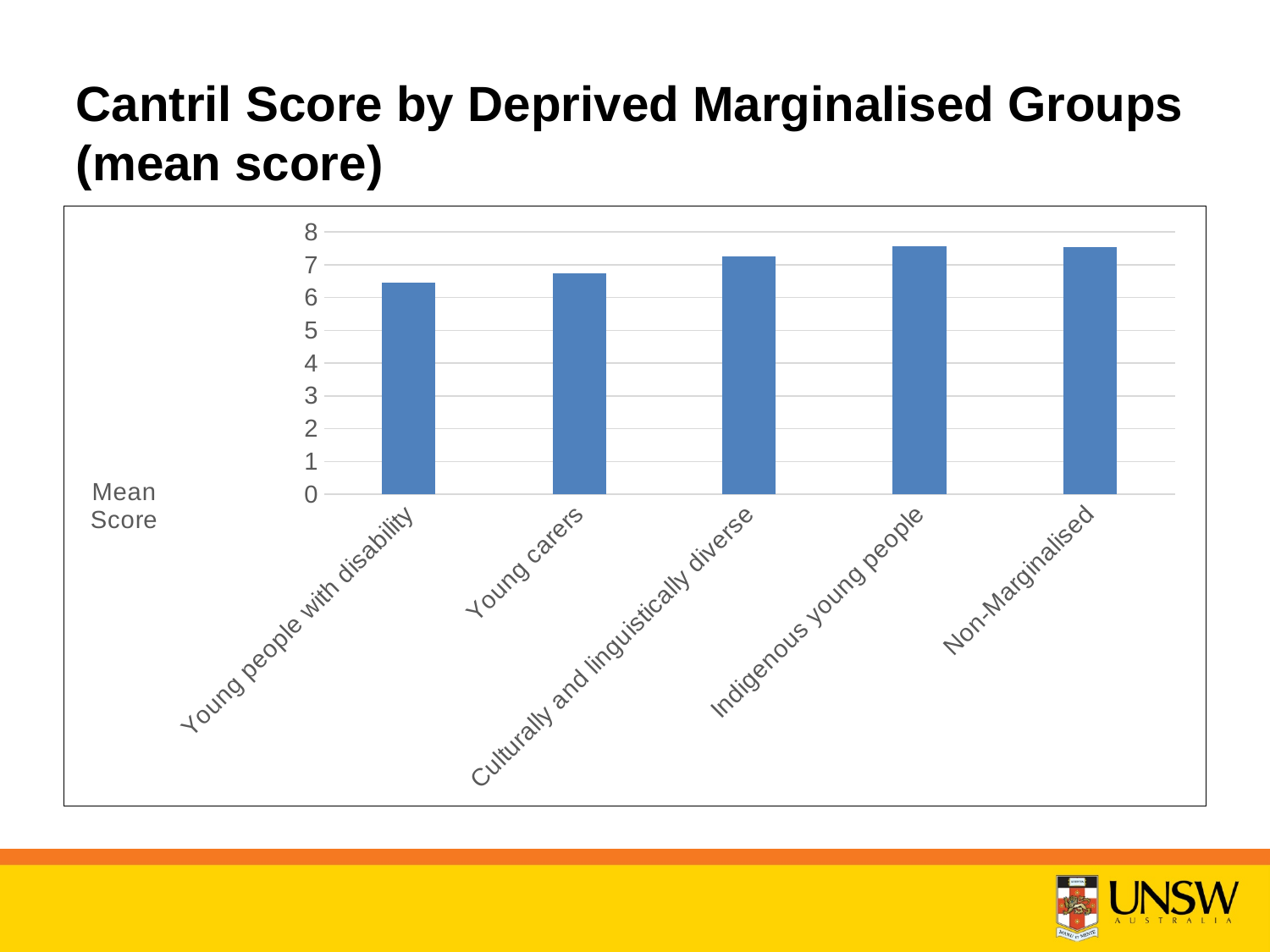
Is the mean score for Non-Marginalised young people greater or less than 7? greater Is the mean score for Culturally and linguistically diverse young people greater or less than 7? greater Which group has the lowest mean Cantril score? Young people with disability Which has the higher mean score: Young carers or Young people with disability? Young carers Is the mean score for Young carers greater or less than 7? less What kind of chart is shown on the slide? bar chart Do the mean scores generally rise or fall moving from left to right across the groups? rise How many groups are plotted on the x axis of the chart? 5 Which has the higher mean score: Indigenous young people or Young carers? Indigenous young people What is the label on the vertical axis of the chart? Mean Score